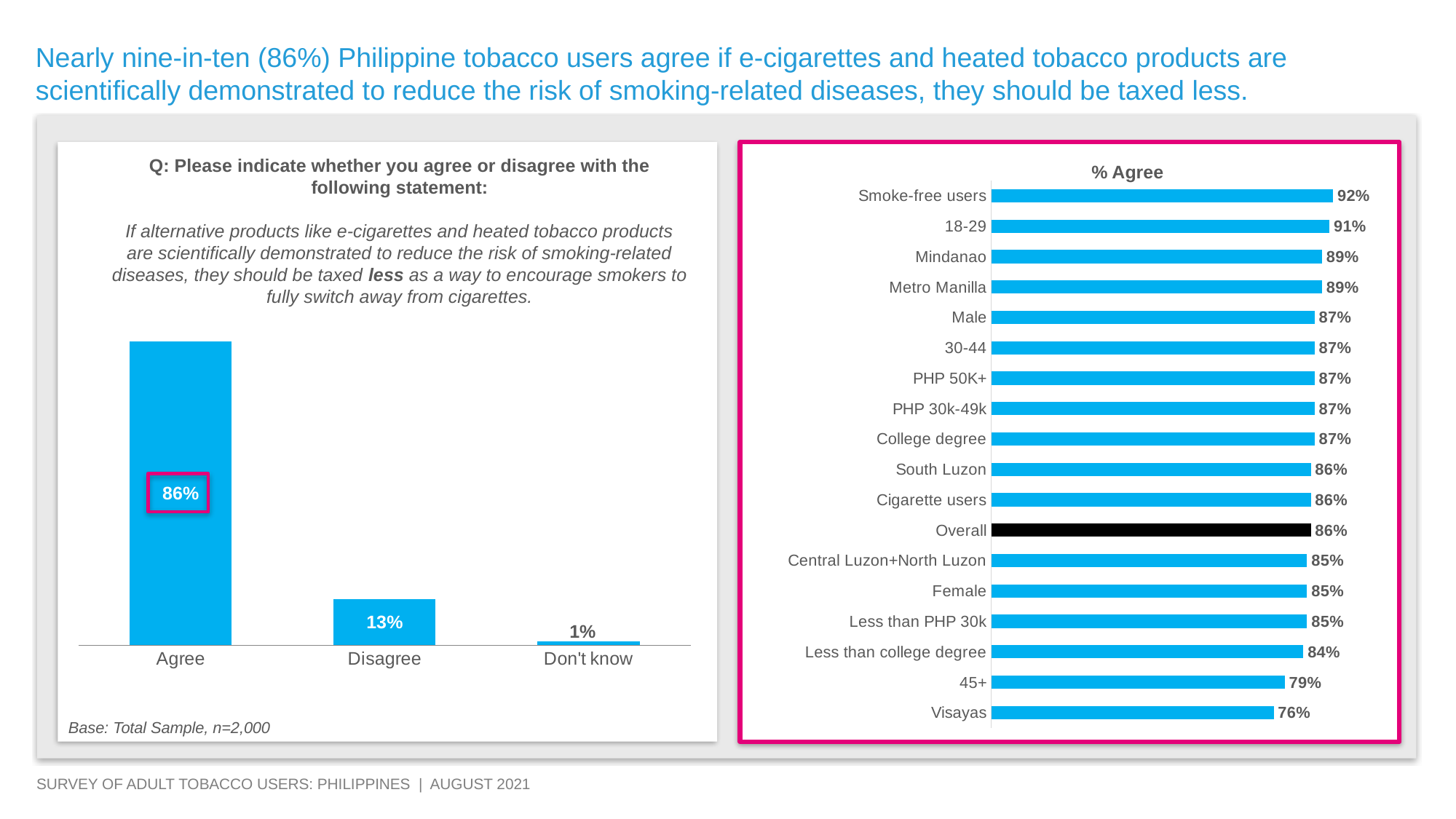
In the '% Agree' chart, what is the value for Visayas? 76% In the left chart, how many response categories are shown? 3 In the left chart, what percentage of respondents answered 'Don't know'? 1% What kind of chart is the left chart? Bar chart In the '% Agree' chart, which group has the lowest percentage agreeing? Visayas In the '% Agree' chart, what is the difference between the 18-29 and 45+ groups? 12 percentage points In the '% Agree' chart, what is the value for Smoke-free users? 92% In the '% Agree' chart, how many groups are listed? 18 In the left chart, what percentage of respondents agree with the statement? 86% In the '% Agree' chart, which is larger, the value for Male or the value for Female? Male In the left chart, what is the difference between the Agree and Disagree percentages? 73 percentage points In the '% Agree' chart, which group has the highest percentage agreeing? Smoke-free users